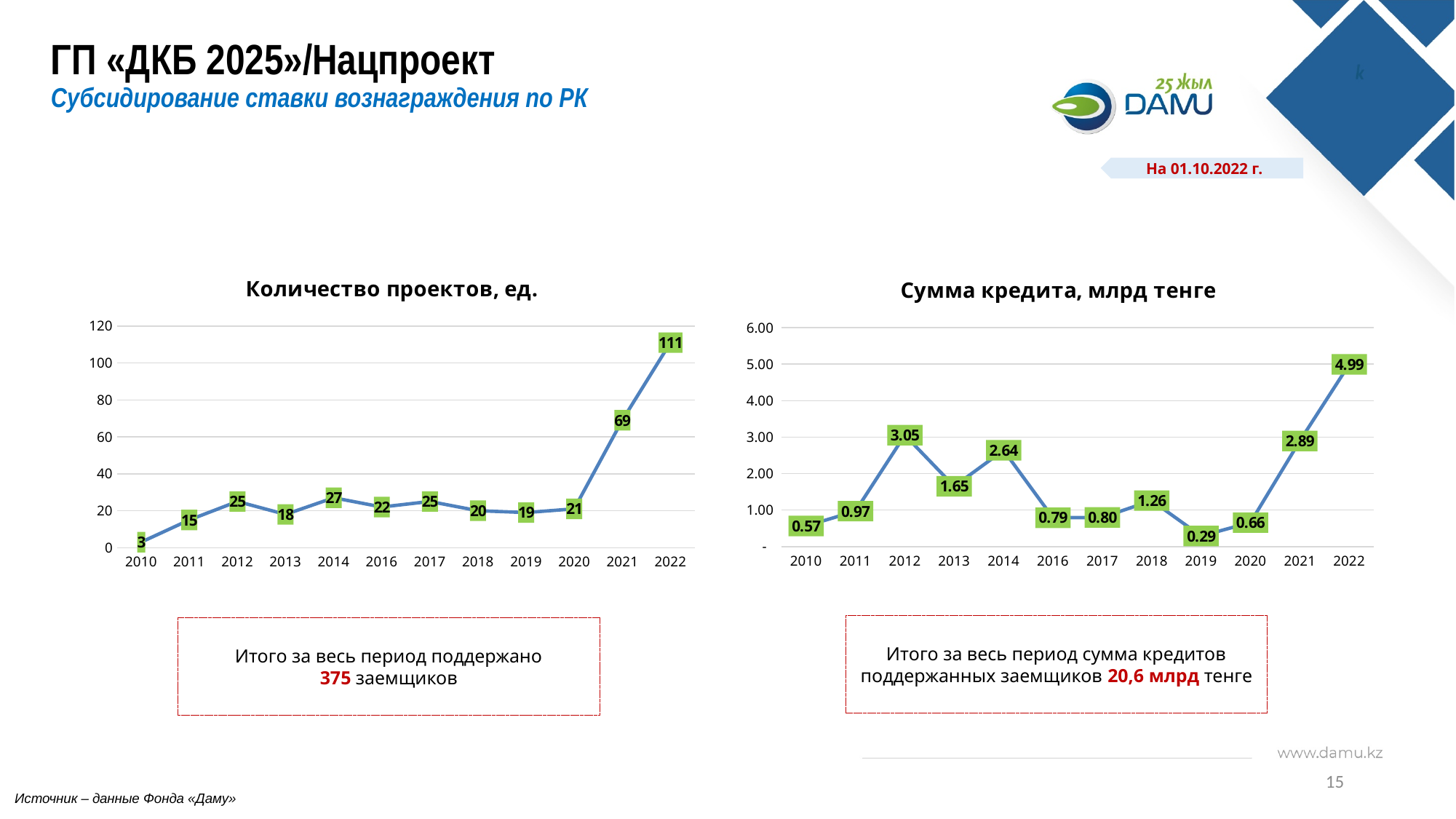
What type of chart is the chart titled «Количество проектов, ед.»? Line chart In the chart titled «Количество проектов, ед.», what is the difference between the values for 2022 and 2021? 42 In the chart titled «Сумма кредита, млрд тенге», which year has the lowest value? 2019 In the chart titled «Сумма кредита, млрд тенге», what is the difference between the values for 2022 and 2021? 2.10 In the chart titled «Количество проектов, ед.», which year has the lowest value? 2010 In the chart titled «Сумма кредита, млрд тенге», which year has the highest value? 2022 In the chart titled «Сумма кредита, млрд тенге», which is larger, the value for 2014 or the value for 2013? 2014 In the chart titled «Количество проектов, ед.», how many data points are plotted? 12 In the chart titled «Сумма кредита, млрд тенге», what is the value for 2012? 3.05 In the chart titled «Сумма кредита, млрд тенге», do the values rise or fall from 2020 to 2022? Rise In the chart titled «Количество проектов, ед.», what is the value for 2021? 69 In the chart titled «Количество проектов, ед.», which year has the highest value? 2022